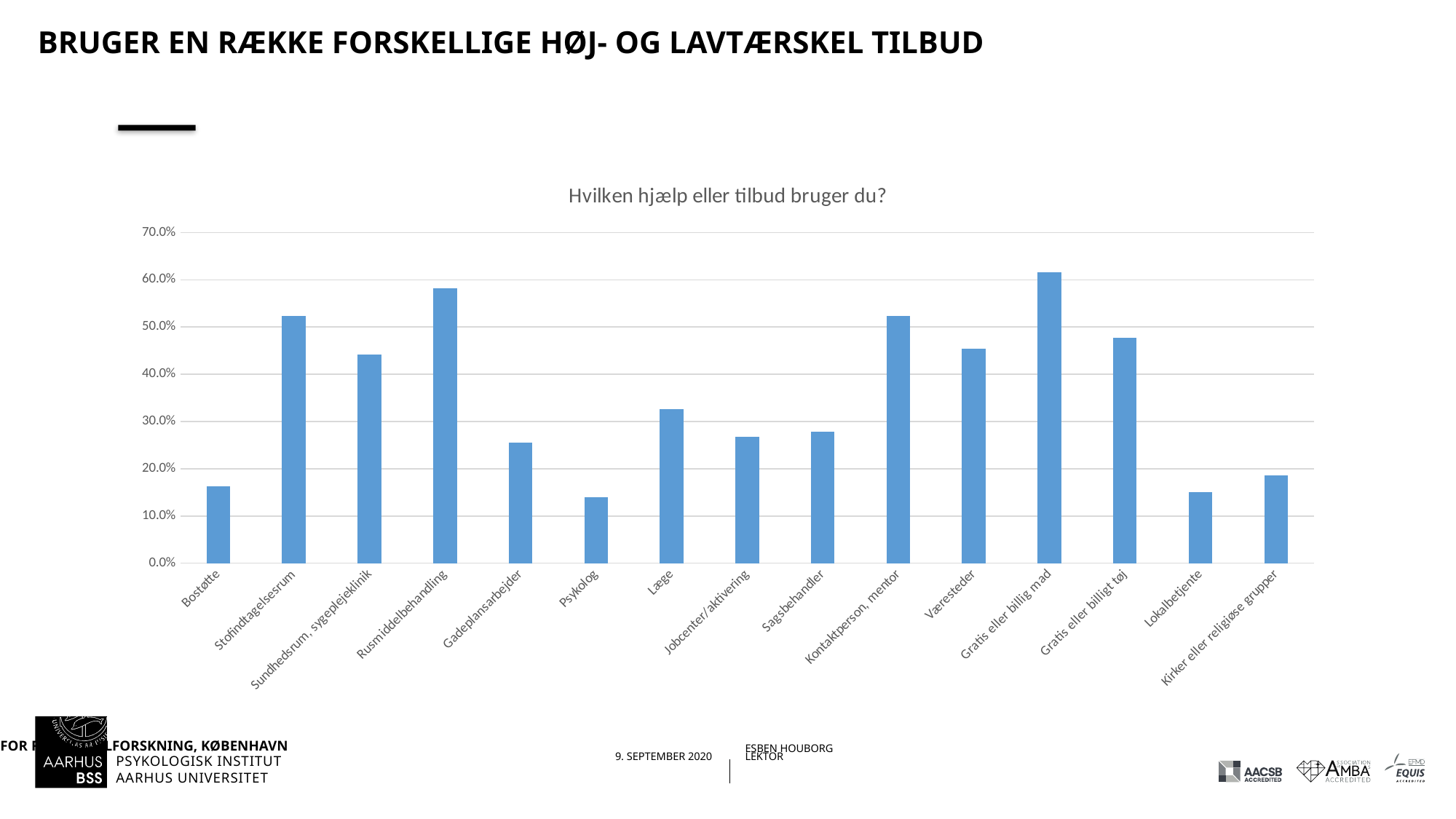
Which has a larger value, Læge or Sagsbehandler? Læge Is the value for Rusmiddelbehandling greater or less than 50.0%? greater Is the value for Bostøtte greater or less than 20.0%? less What is the title of the chart? Hvilken hjælp eller tilbud bruger du? Is the value for Læge greater or less than 30.0%? greater What is the highest value shown on the y axis of the chart? 70.0% What type of chart is shown on the slide? bar chart Which has a larger value, Stofindtagelsesrum or Sundhedsrum, sygeplejeklinik? Stofindtagelsesrum Which category has the highest value in the chart? Gratis eller billig mad How many categories are shown on the x axis of the chart? 15